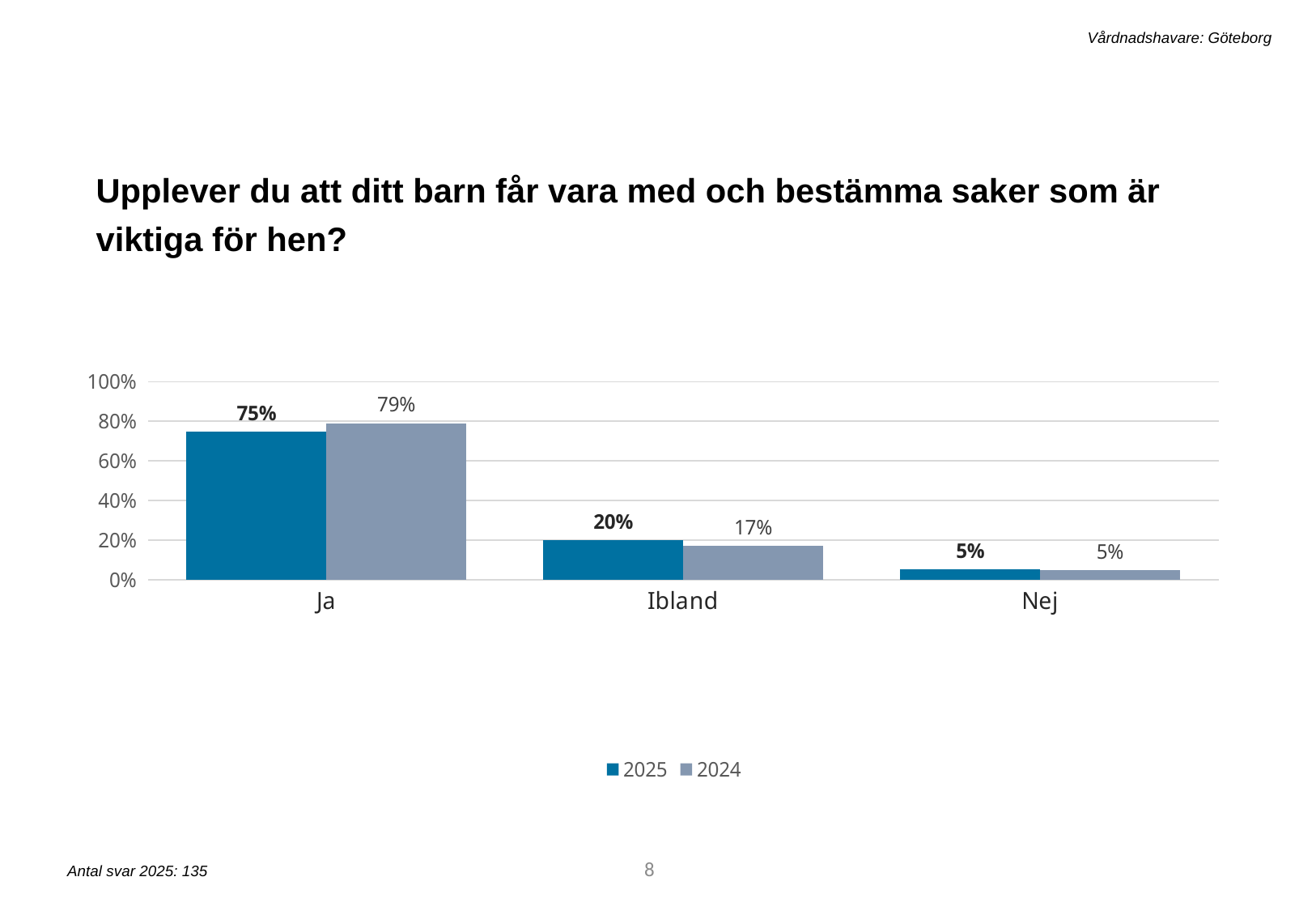
What is the difference between the 2025 and 2024 values for "Ibland"? 3% What is the difference between the 2024 and 2025 values for "Ja"? 4% What is the value for "Ibland" in the 2025 series? 20% Which category has the lowest value in the 2024 series? Nej How many categories are shown on the x axis? 3 What is the value for "Ja" in the 2025 series? 75% Which category has the highest value in the 2025 series? Ja How many series does the legend list? 2 What kind of chart is shown on the slide? Bar chart Which is larger for "Ibland": the 2025 value or the 2024 value? 2025 What is the value for "Nej" in the 2024 series? 5% What is the value for "Ja" in the 2024 series? 79%